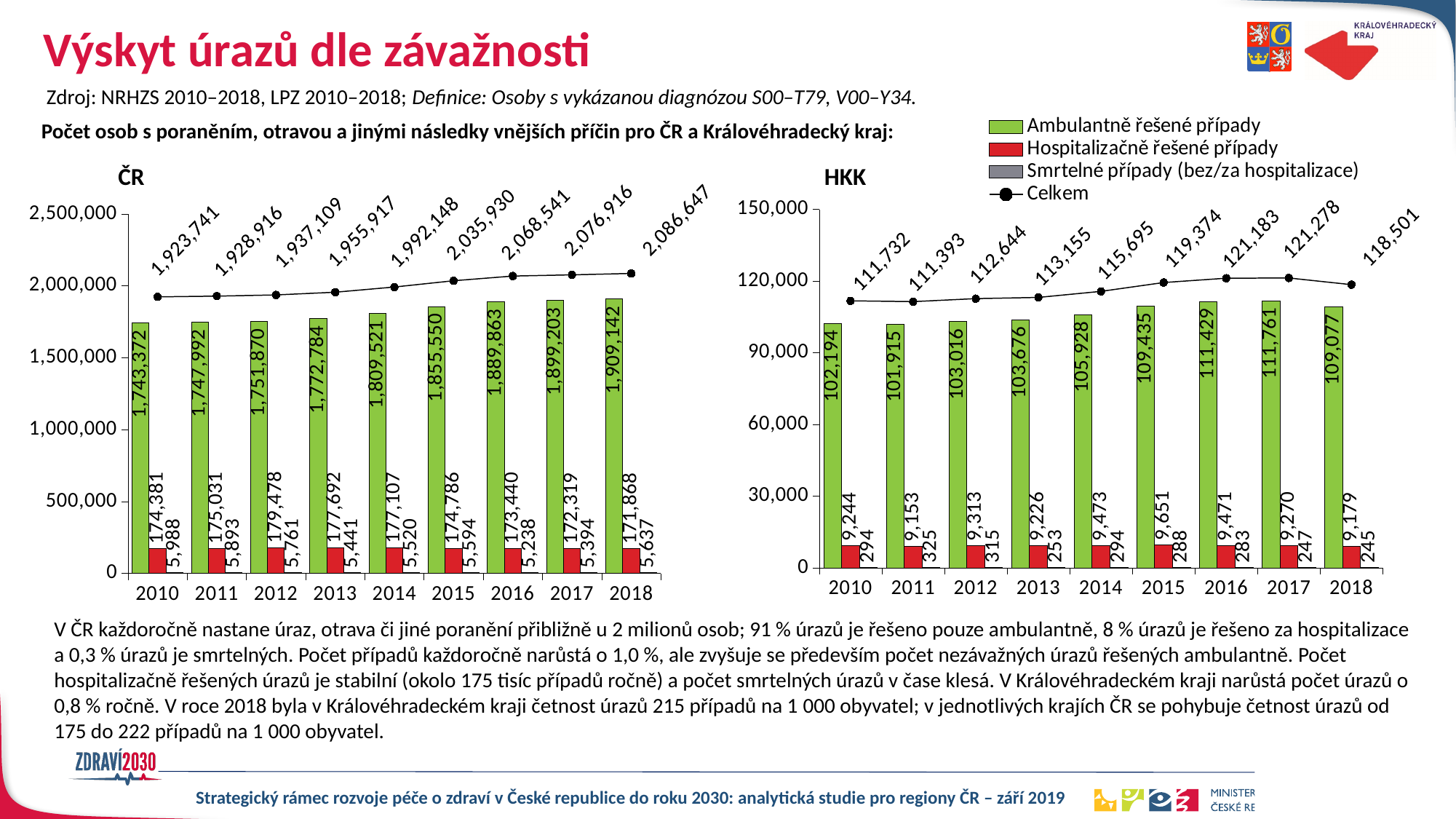
In the HKK chart, which year has the highest Celkem value? 2017 How many years are shown on the x axis of the HKK chart? 9 In the HKK chart, what is the difference between the Celkem values for 2017 and 2018? 2,777 In the HKK chart, what is the value of Smrtelné případy in 2018? 245 In the ČR chart, what is the Celkem value for 2010? 1,923,741 In the ČR chart, what is the difference between the Celkem values for 2018 and 2010? 162,906 In the ČR chart, does the Celkem line rise or fall from 2010 to 2018? rise How many series does the legend list? 4 In the ČR chart, is the value of Hospitalizačně řešené případy larger in 2012 or in 2018? 2012 In the ČR chart, what is the value of Ambulantně řešené případy in 2018? 1,909,142 In the ČR chart, which year has the lowest value of Smrtelné případy? 2016 In the HKK chart, what is the value of Hospitalizačně řešené případy in 2015? 9,651